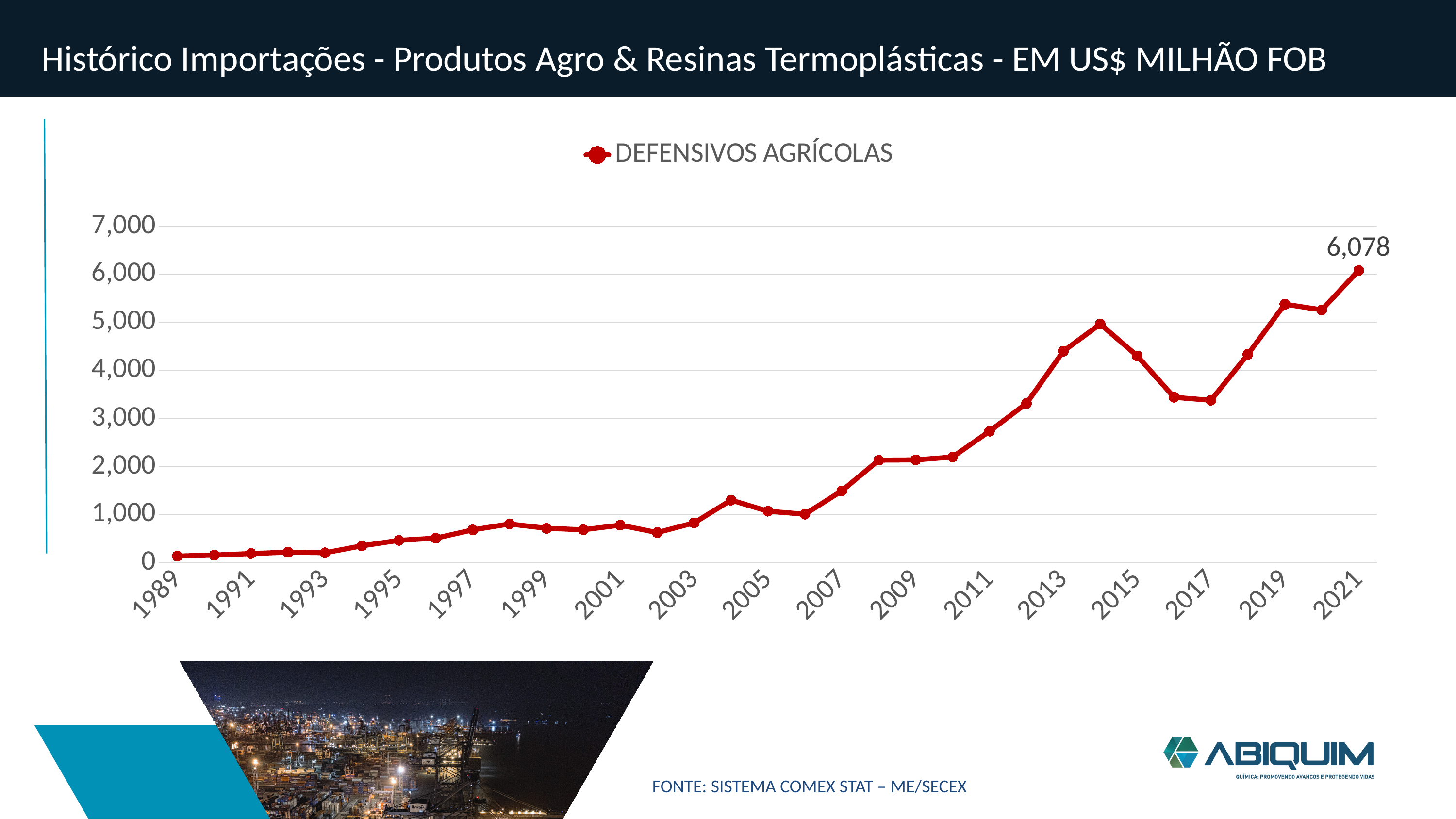
Do the values generally rise or fall from 1989 to 2021? rise What kind of chart is shown on the slide? line chart What is the value for 2021 in the DEFENSIVOS AGRÍCOLAS series? 6,078 How many series does the legend list? 1 Is the value for 2014 greater or less than 4,000? greater Is the value for 2009 greater or less than 3,000? less Is the value for 1999 greater or less than 1,000? less Which is larger, the value for 2014 or the value for 2017? 2014 How many data points are plotted on the line? 33 Which year has the highest value for DEFENSIVOS AGRÍCOLAS? 2021 Which is larger, the value for 2004 or the value for 2006? 2004